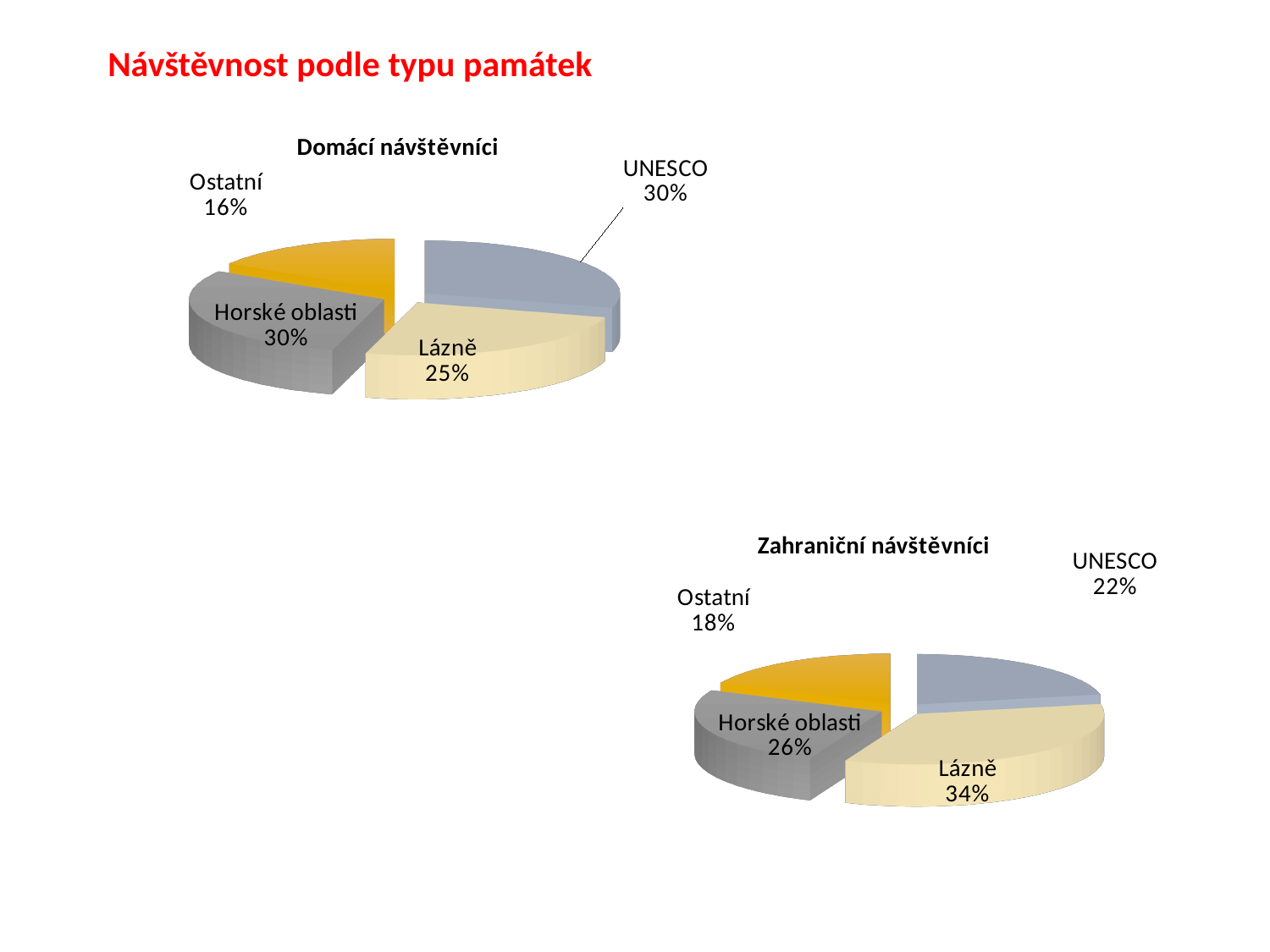
In the 'Domácí návštěvníci' chart, which is larger: the share of Lázně or the share of Ostatní? Lázně What kind of chart is the 'Zahraniční návštěvníci' chart? Pie chart In the 'Domácí návštěvníci' chart, which category has the smallest share? Ostatní In the 'Zahraniční návštěvníci' chart, which category has the smallest share? Ostatní In the 'Domácí návštěvníci' chart, what share does Lázně have? 25% How many categories does the 'Domácí návštěvníci' chart show? 4 What is the title of the chart in the upper left of the slide? Domácí návštěvníci In the 'Zahraniční návštěvníci' chart, what share does UNESCO have? 22% In the 'Zahraniční návštěvníci' chart, which category has the largest share? Lázně In the 'Zahraniční návštěvníci' chart, what is the difference between the shares of Lázně and Horské oblasti? 8% In the 'Zahraniční návštěvníci' chart, what share does Lázně have? 34% In the 'Domácí návštěvníci' chart, what share does Ostatní have? 16%